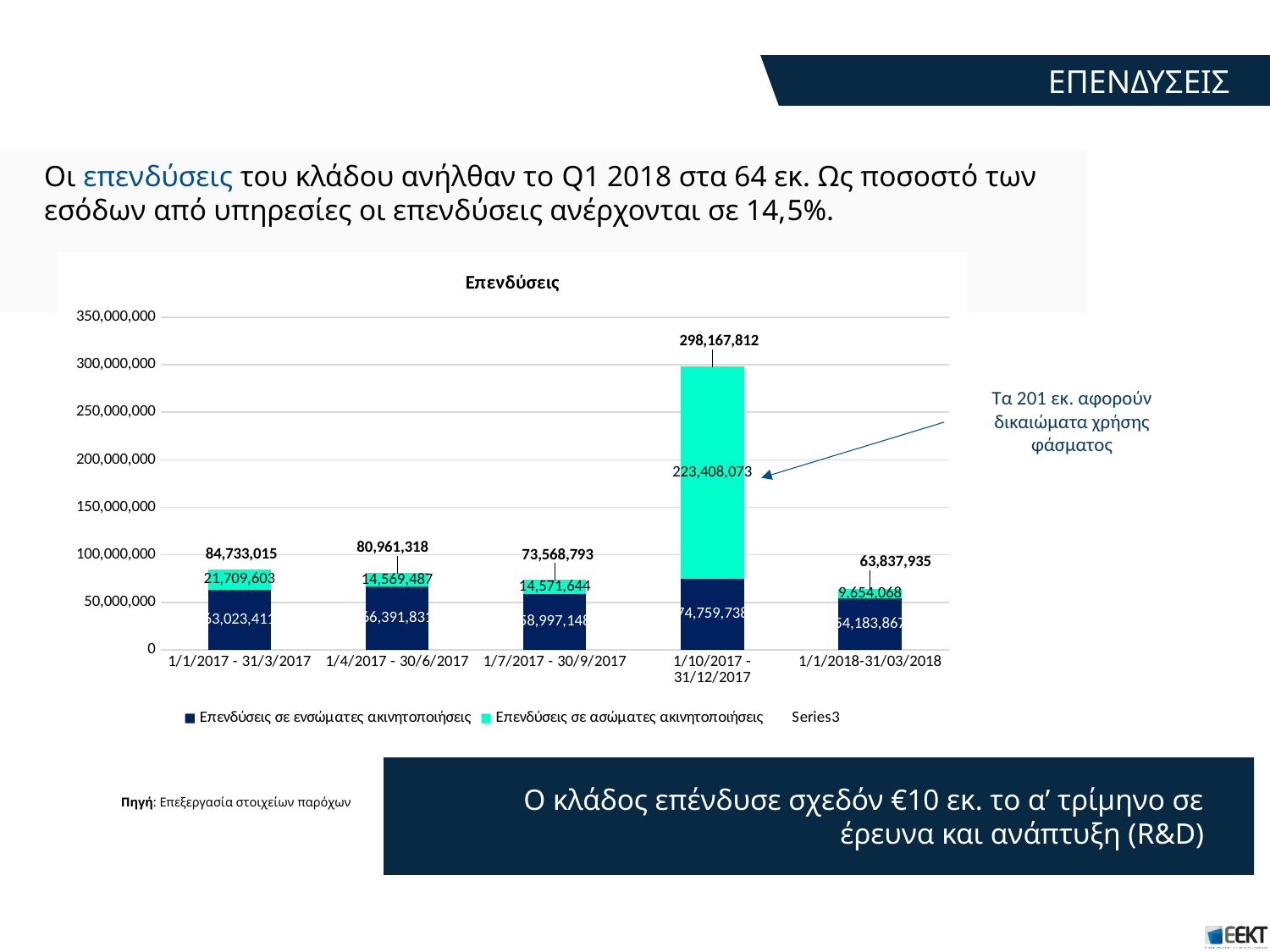
Which is larger: the total investment for 1/4/2017 - 30/6/2017 or for 1/7/2017 - 30/9/2017? 1/4/2017 - 30/6/2017 Which period has the lowest total investment? 1/1/2018-31/03/2018 Is the value of Επενδύσεις σε ενσώματες ακινητοποιήσεις for 1/10/2017 - 31/12/2017 greater or less than 100,000,000? less What kind of chart is shown on the slide? Stacked bar chart Which period has the highest total investment? 1/10/2017 - 31/12/2017 What is the value of Επενδύσεις σε ασώματες ακινητοποιήσεις for the period 1/1/2017 - 31/3/2017? 21,709,603 How many series does the chart legend list? 3 How many periods are shown on the x axis of the chart? 5 What is the value of Επενδύσεις σε ασώματες ακινητοποιήσεις for the period 1/10/2017 - 31/12/2017? 223,408,073 What is the total investment value shown for the period 1/1/2018-31/03/2018? 63,837,935 What is the difference between the total investment for 1/1/2017 - 31/3/2017 and for 1/1/2018-31/03/2018? 20,895,080 What is the total investment value shown for the period 1/10/2017 - 31/12/2017? 298,167,812